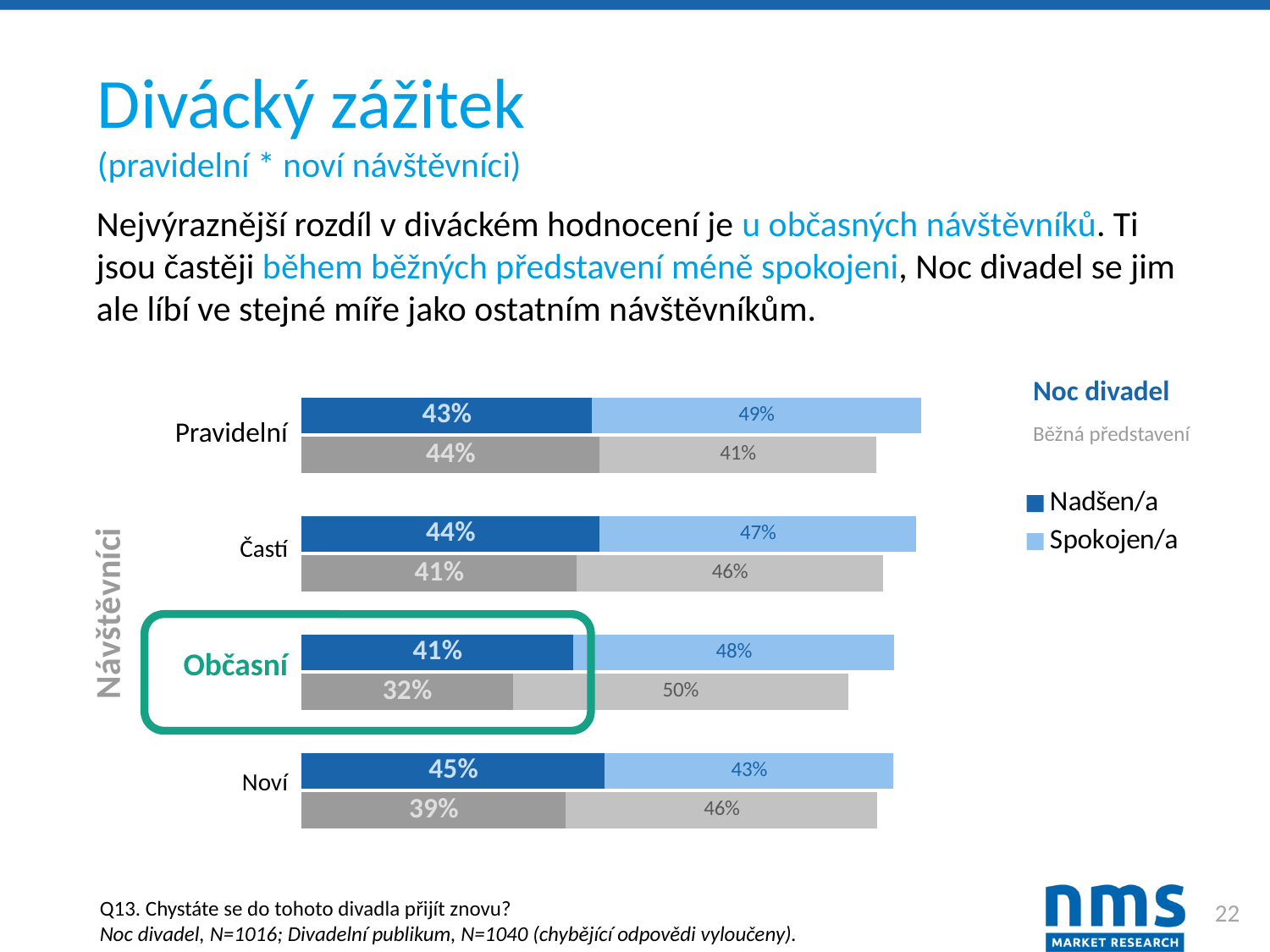
What type of chart is shown on the slide? Stacked bar chart How many series does the legend list? 2 What is the Spokojen/a value for Pravidelní visitors at Noc divadel? 49% What is the total of the Noc divadel stacked bar for Častí visitors? 91% What is the Nadšen/a value for Občasní visitors at Běžná představení? 32% What is the difference between the Nadšen/a values for Občasní visitors at Noc divadel and at Běžná představení? 9 percentage points How many visitor groups are shown on the y axis of the chart? 4 What is the Nadšen/a value for Noví visitors at Noc divadel? 45% Which is larger for Noví visitors at Noc divadel: Nadšen/a or Spokojen/a? Nadšen/a Which visitor group has the highest Nadšen/a value for Noc divadel? Noví Which visitor group has the lowest Nadšen/a value for Běžná představení? Občasní What is the Spokojen/a value for Častí visitors at Běžná představení? 46%